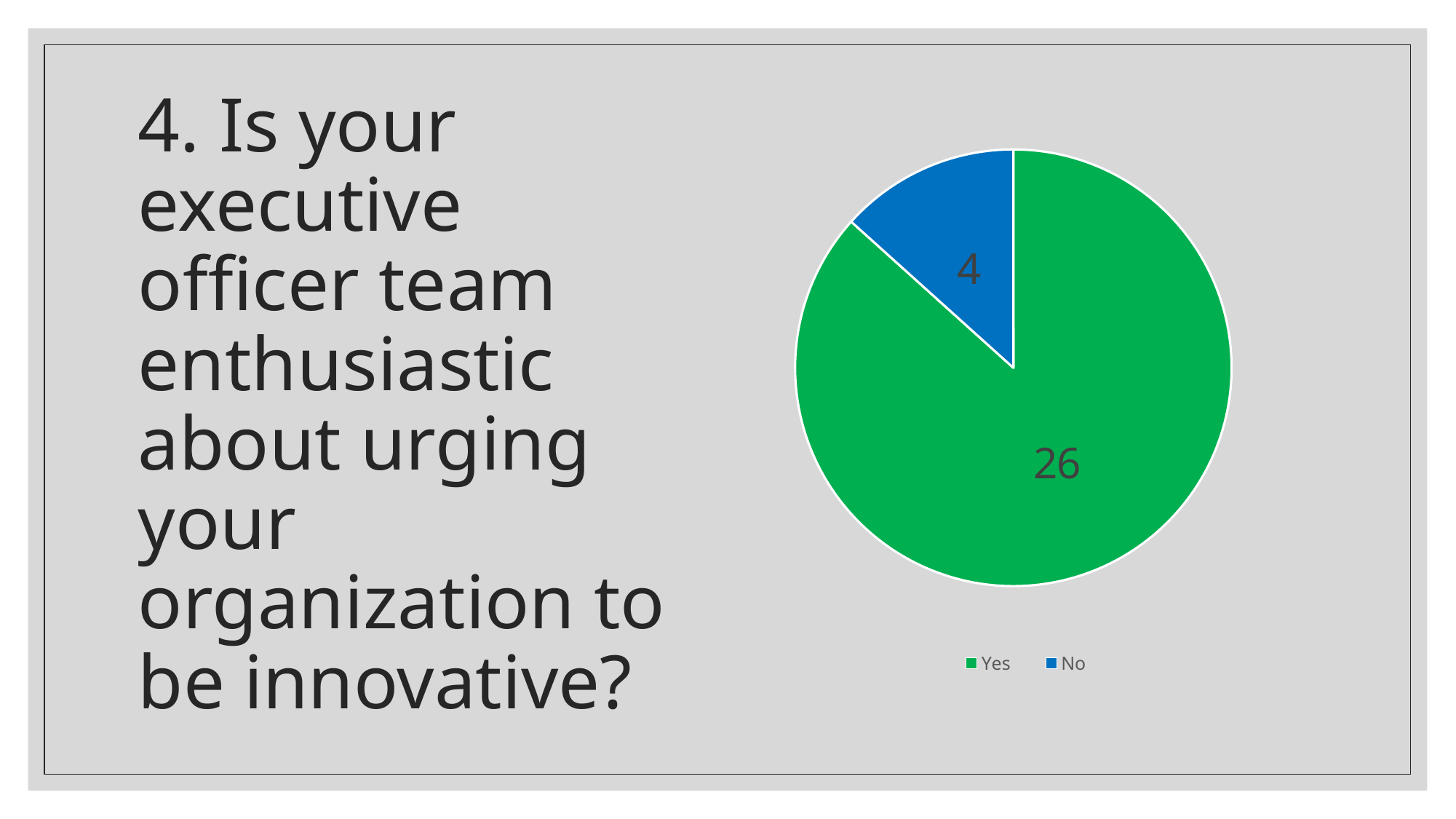
What is the value for No? 4 How many categories does the pie chart have? 2 Which category has the smallest slice? No What is the difference between the Yes and No values? 22 What is the value for Yes? 26 What colour is the Yes slice? green Which category has the largest slice? Yes How many entries does the legend list? 2 What type of chart is shown on the slide? pie chart What colour is the No slice? blue Which is larger, Yes or No? Yes What is the total of all slices in the pie chart? 30